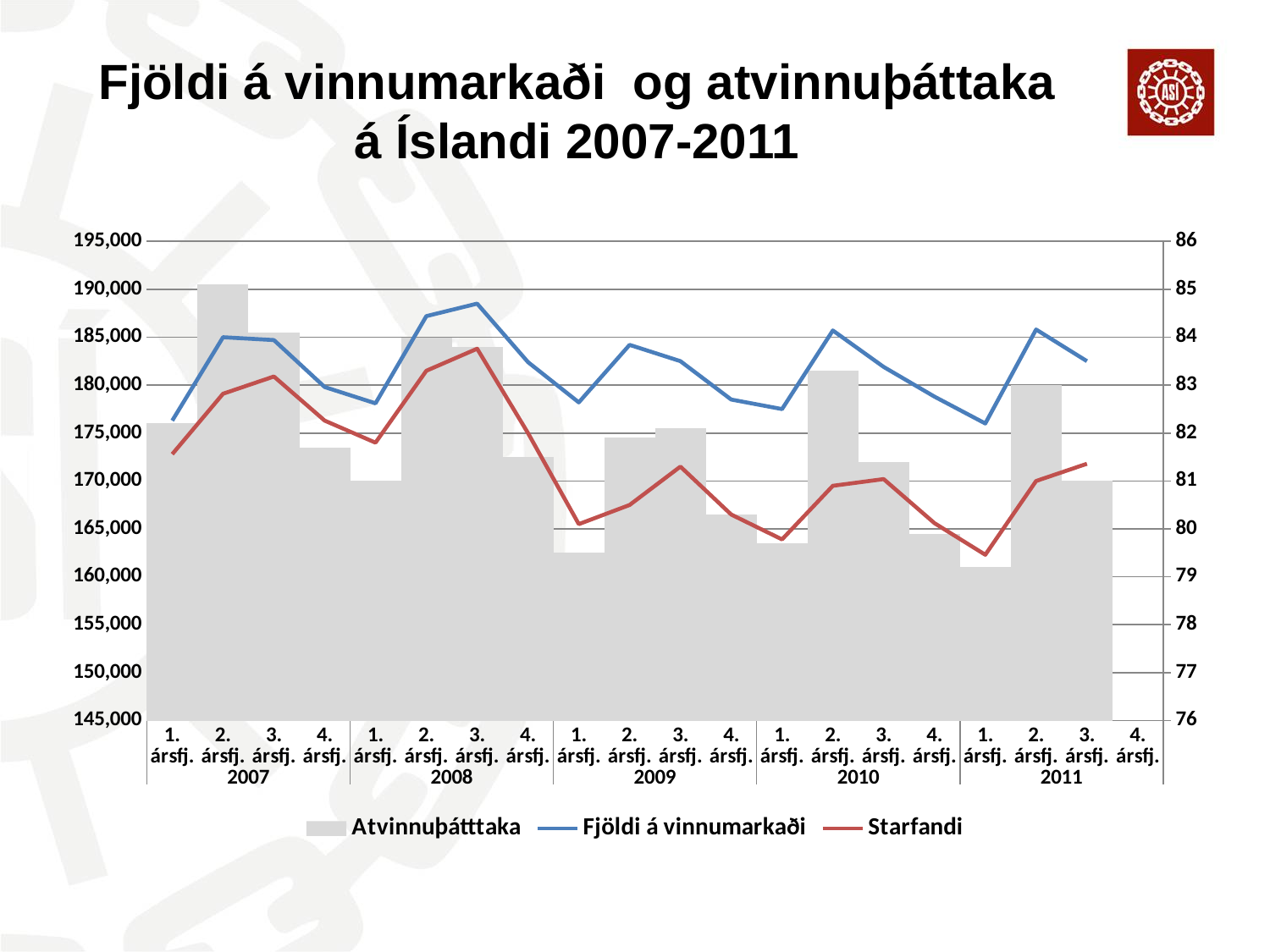
Does the Starfandi line rise or fall from 3. ársfj. 2008 to 1. ársfj. 2009? fall Is the Fjöldi á vinnumarkaði value for 3. ársfj. 2008 greater or less than 185,000? greater How many series does the legend list? 3 In which quarter is the Atvinnuþátttaka bar the tallest? 2. ársfj. 2007 How many years are shown along the x axis? 5 Which series is plotted as bars rather than a line? Atvinnuþátttaka Is the Atvinnuþátttaka value for 2. ársfj. 2007 greater or less than 84? greater Is the Starfandi value for 1. ársfj. 2009 greater or less than 170,000? less In which quarter does the Starfandi line reach its highest value? 3. ársfj. 2008 What kind of chart is shown on the slide? A combination bar and line chart In which quarter does the Fjöldi á vinnumarkaði line reach its highest value? 3. ársfj. 2008 Which is larger, the Fjöldi á vinnumarkaði value for 2. ársfj. 2008 or for 2. ársfj. 2009? 2. ársfj. 2008